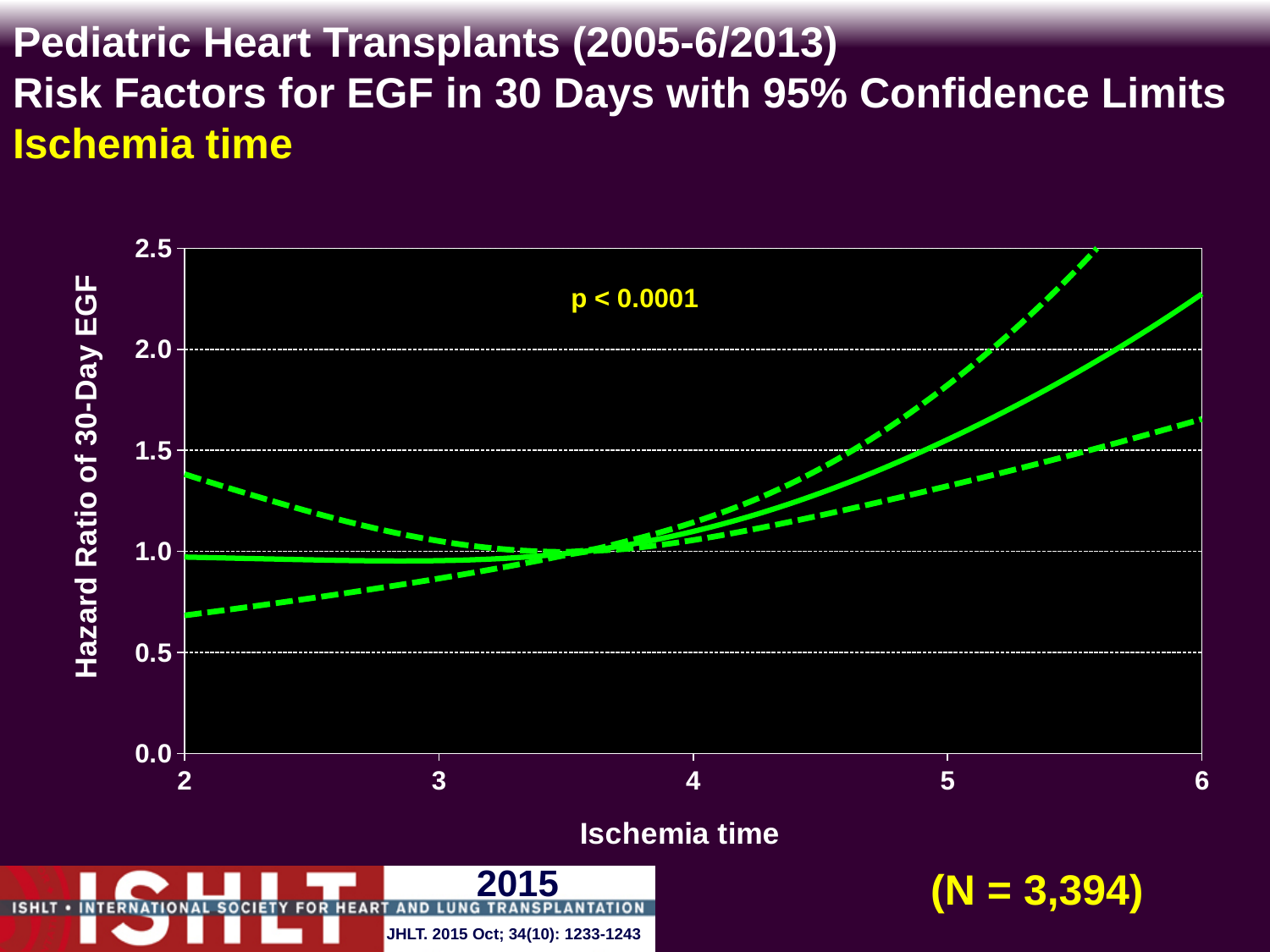
What is the label of the x axis? Ischemia time Is the upper dashed confidence limit at an ischemia time of 2 greater or less than 1.5? less What is the label of the y axis? Hazard Ratio of 30-Day EGF Does the solid hazard ratio line rise or fall as ischemia time increases from 4 to 6? rise What p-value is printed on the chart? p < 0.0001 What kind of chart is shown on the slide? line chart Is the lower dashed confidence limit at an ischemia time of 6 greater or less than 1.5? greater Is the lower dashed confidence limit at an ischemia time of 2 greater or less than 1.0? less How many lines are plotted on the chart? 3 What sample size (N) is shown on the slide? N = 3,394 What is the highest value shown on the y axis? 2.5